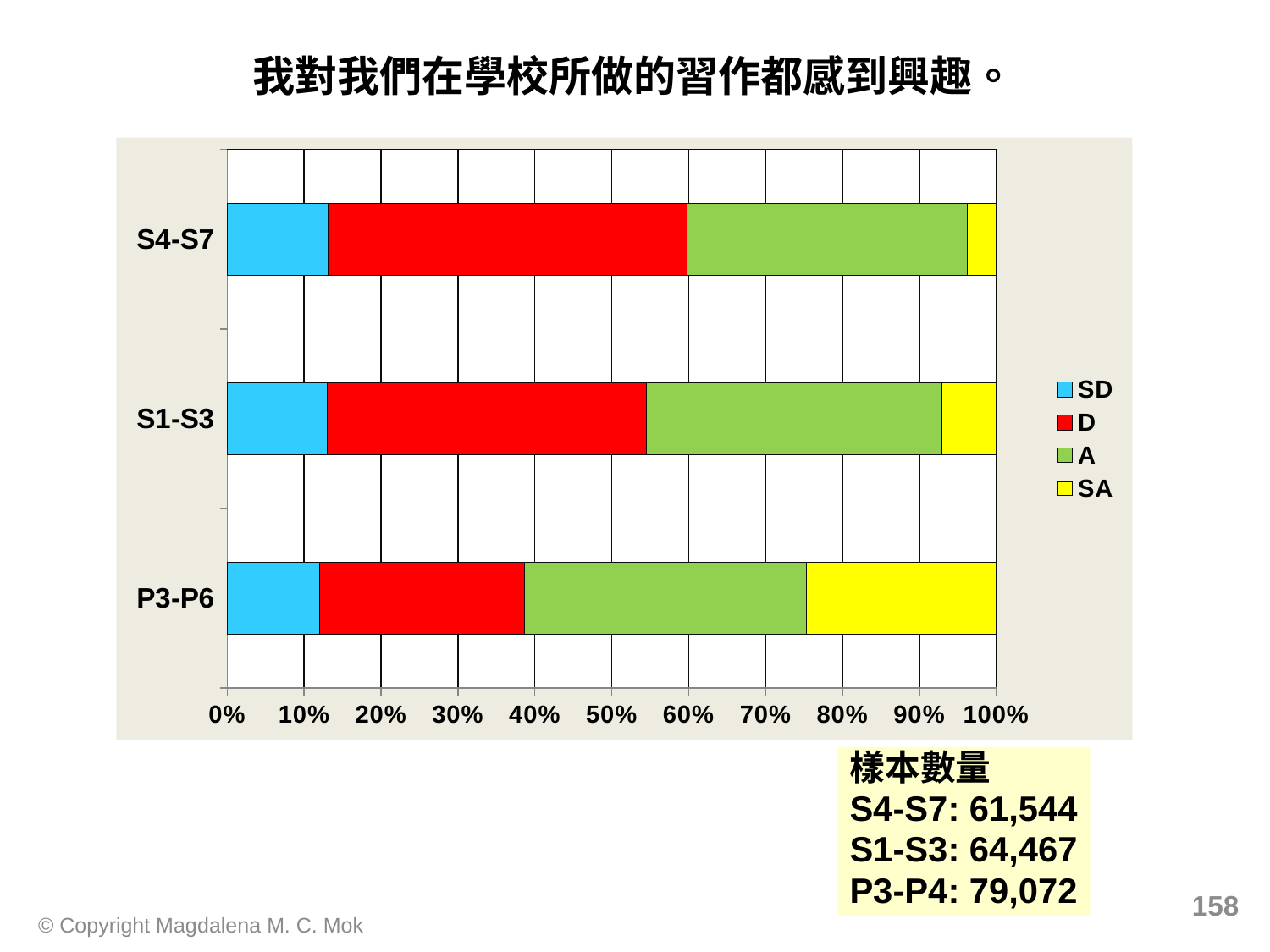
Is the SD share for P3-P6 greater or less than 20%? less What are the legend entries of the chart, in order? SD, D, A, SA Is the SA share for P3-P6 greater or less than 20%? greater What kind of chart is shown on the slide? Stacked bar chart Which colour represents the SA series in the chart? Yellow Is the D share for S4-S7 greater or less than 40%? greater Which group has the smallest SA share? S4-S7 Which group has the largest SA share? P3-P6 Which is larger: the D share for S4-S7 or the D share for P3-P6? S4-S7 How many series does the legend list? 4 How many categories (student groups) are plotted on the chart? 3